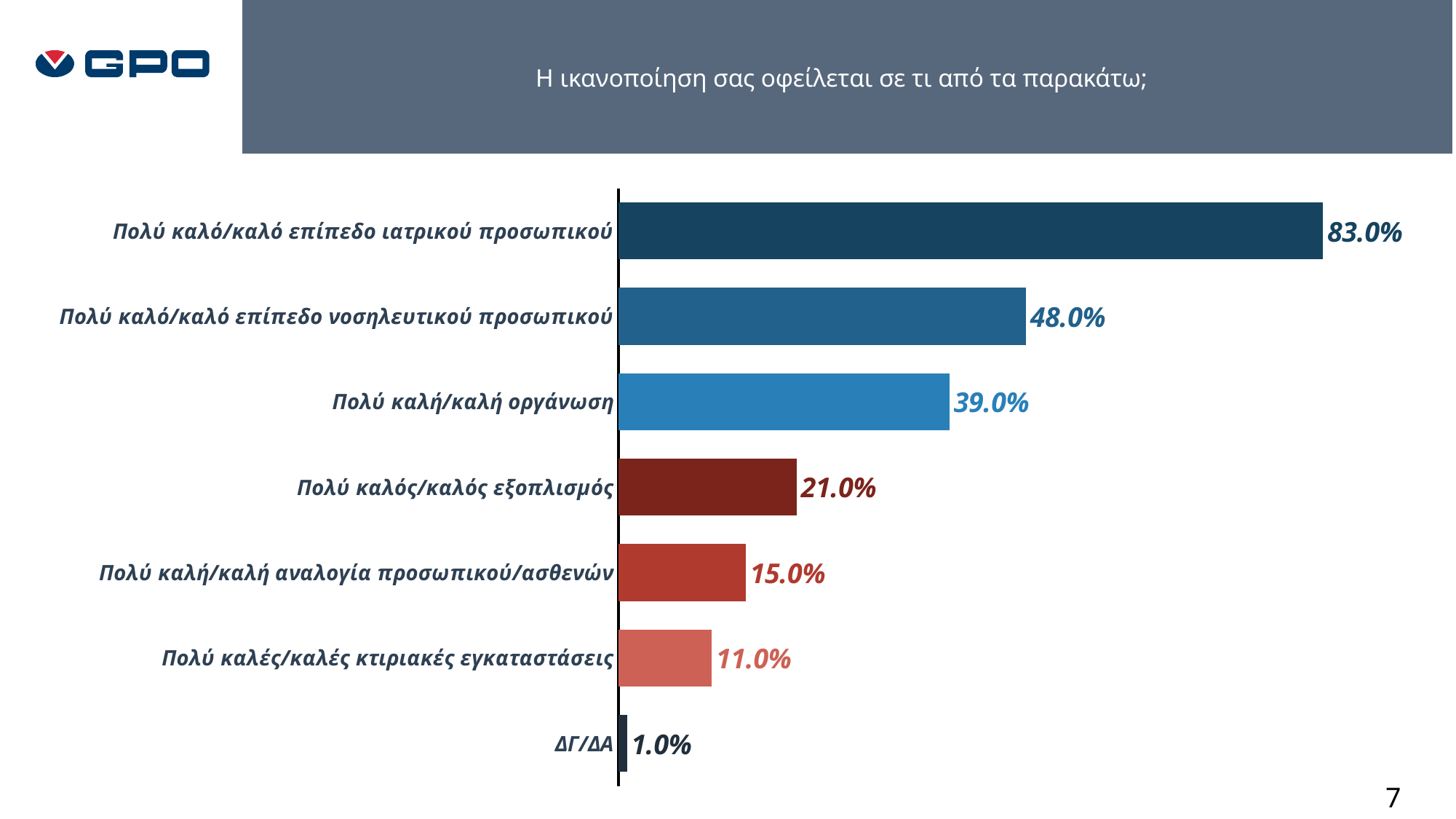
What is the value for "Πολύ καλές/καλές κτιριακές εγκαταστάσεις"? 11.0% Which category has the highest value? Πολύ καλό/καλό επίπεδο ιατρικού προσωπικού What is the value for "Πολύ καλή/καλή οργάνωση"? 39.0% Which is larger, the value for "Πολύ καλό/καλό επίπεδο νοσηλευτικού προσωπικού" or for "Πολύ καλή/καλή οργάνωση"? Πολύ καλό/καλό επίπεδο νοσηλευτικού προσωπικού What is the value for "ΔΓ/ΔΑ"? 1.0% Which category has the lowest value? ΔΓ/ΔΑ What is the difference between the values for "Πολύ καλός/καλός εξοπλισμός" and "Πολύ καλή/καλή αναλογία προσωπικού/ασθενών"? 6.0% What is the value for "Πολύ καλό/καλό επίπεδο ιατρικού προσωπικού"? 83.0% What is the difference between the values for "Πολύ καλό/καλό επίπεδο ιατρικού προσωπικού" and "Πολύ καλό/καλό επίπεδο νοσηλευτικού προσωπικού"? 35.0% How many categories are shown in the chart? 7 What kind of chart is shown on the slide? Bar chart What is the title of the chart? Η ικανοποίηση σας οφείλεται σε τι από τα παρακάτω;